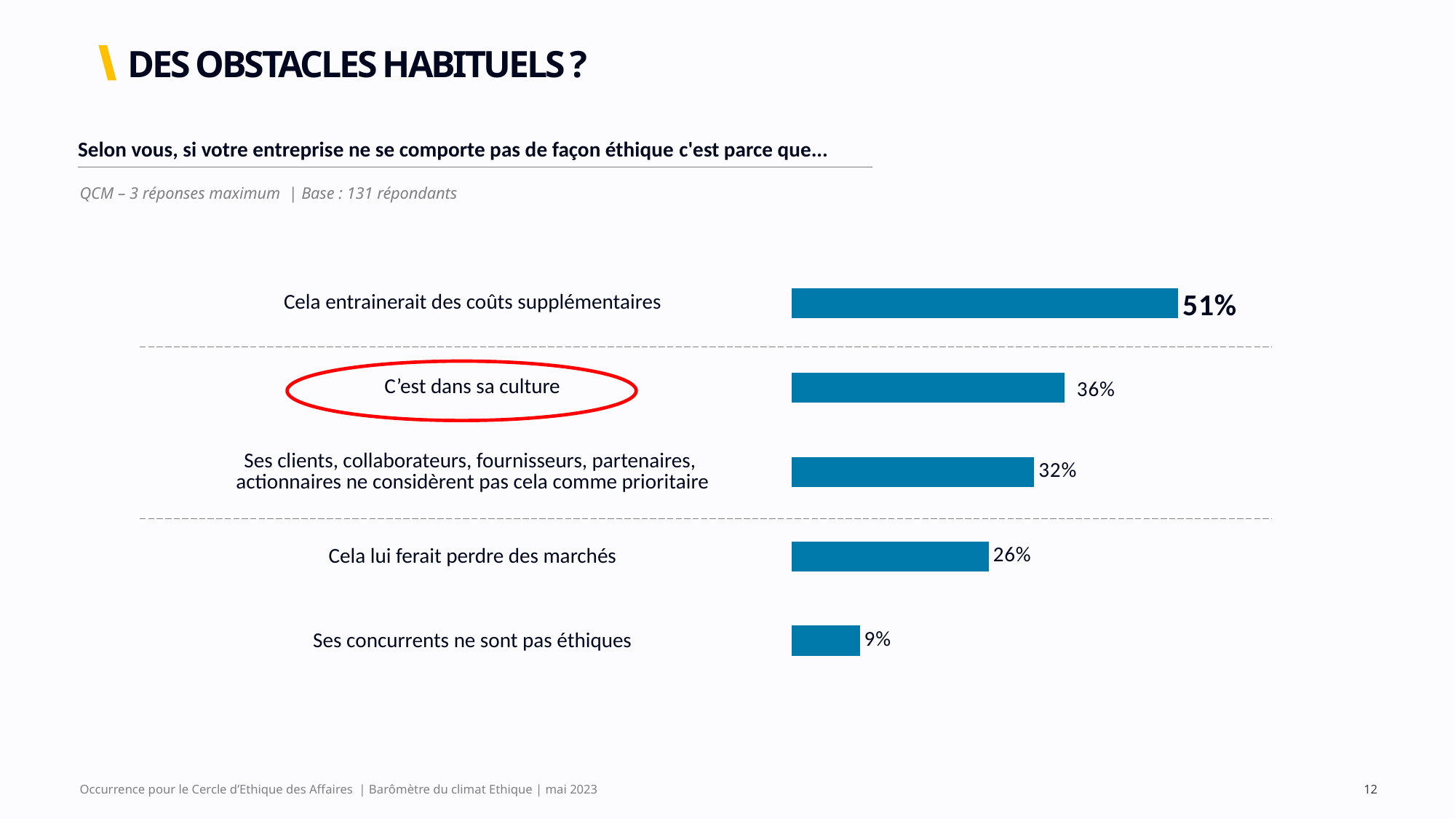
Which is larger: the value for "Cela lui ferait perdre des marchés" or the value for "Ses clients, collaborateurs, fournisseurs, partenaires, actionnaires ne considèrent pas cela comme prioritaire"? Ses clients, collaborateurs, fournisseurs, partenaires, actionnaires ne considèrent pas cela comme prioritaire Which category has the lowest value? Ses concurrents ne sont pas éthiques What kind of chart is shown on the slide? Bar chart What percentage is shown for "Cela entrainerait des coûts supplémentaires"? 51% How many categories are shown in the chart? 5 What percentage is shown for "Cela lui ferait perdre des marchés"? 26% Which category has the highest value? Cela entrainerait des coûts supplémentaires What value is shown for "Ses concurrents ne sont pas éthiques"? 9% What is the difference between the values for "Cela entrainerait des coûts supplémentaires" and "C'est dans sa culture"? 15% What value is shown for "C'est dans sa culture"? 36% Which category label is circled in red on the slide? C'est dans sa culture What is the difference between the values for "C'est dans sa culture" and "Ses concurrents ne sont pas éthiques"? 27%